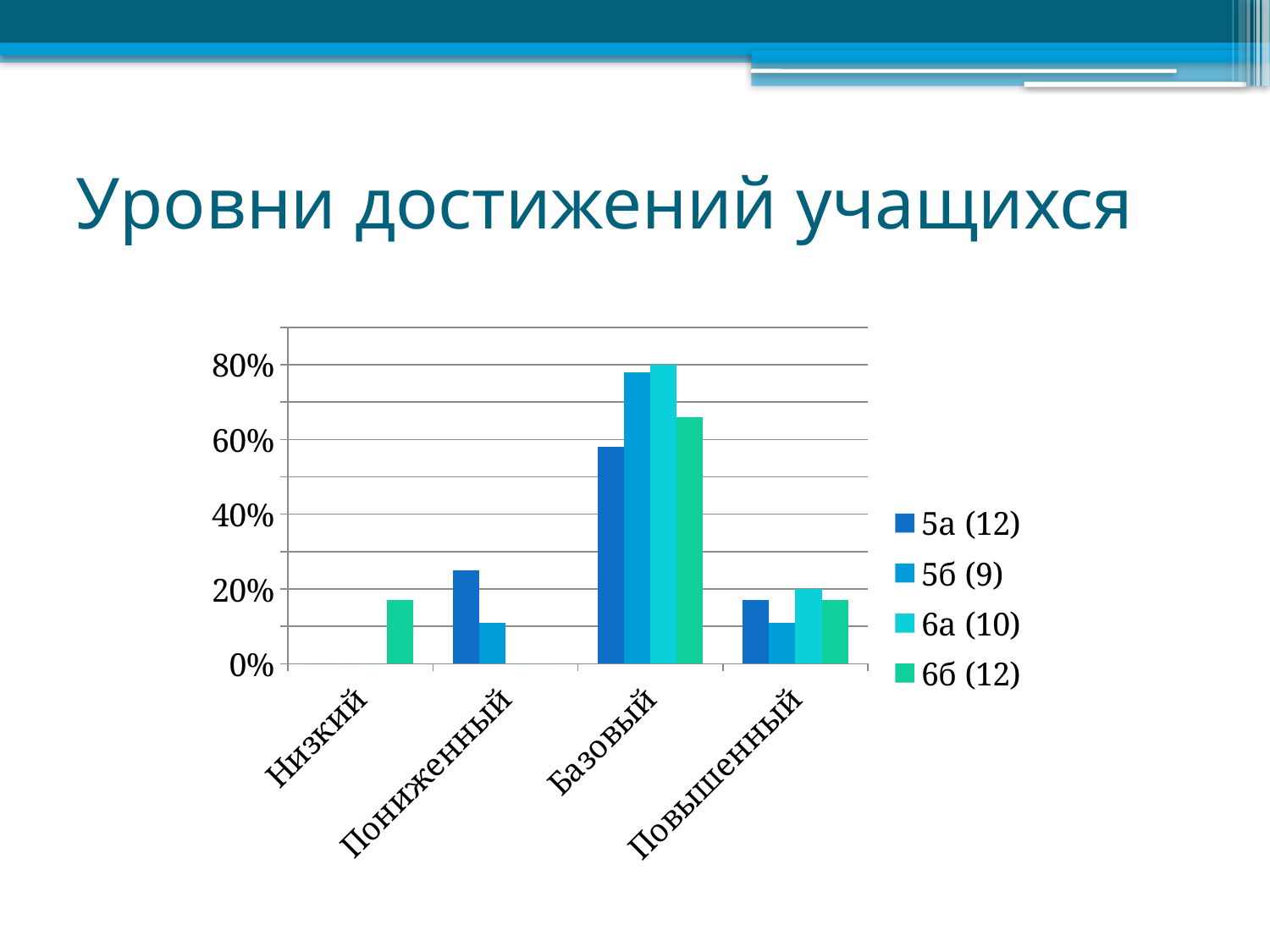
Which category has the highest values across all series? Базовый In the Базовый category, which is larger: the value for 5а (12) or the value for 6а (10)? 6а (10) Is the value for 5а (12) in the Пониженный category greater or less than 20%? greater What kind of chart is shown on the slide? bar chart In the Пониженный category, which is larger: the value for 5а (12) or the value for 5б (9)? 5а (12) What is the title of the slide containing the chart? Уровни достижений учащихся How many categories are shown on the x axis of the chart? 4 Which series is listed first in the chart legend? 5а (12) Is the value for 5б (9) in the Базовый category greater or less than 60%? greater Is the value for 6б (12) in the Базовый category greater or less than 80%? less How many series does the chart legend list? 4